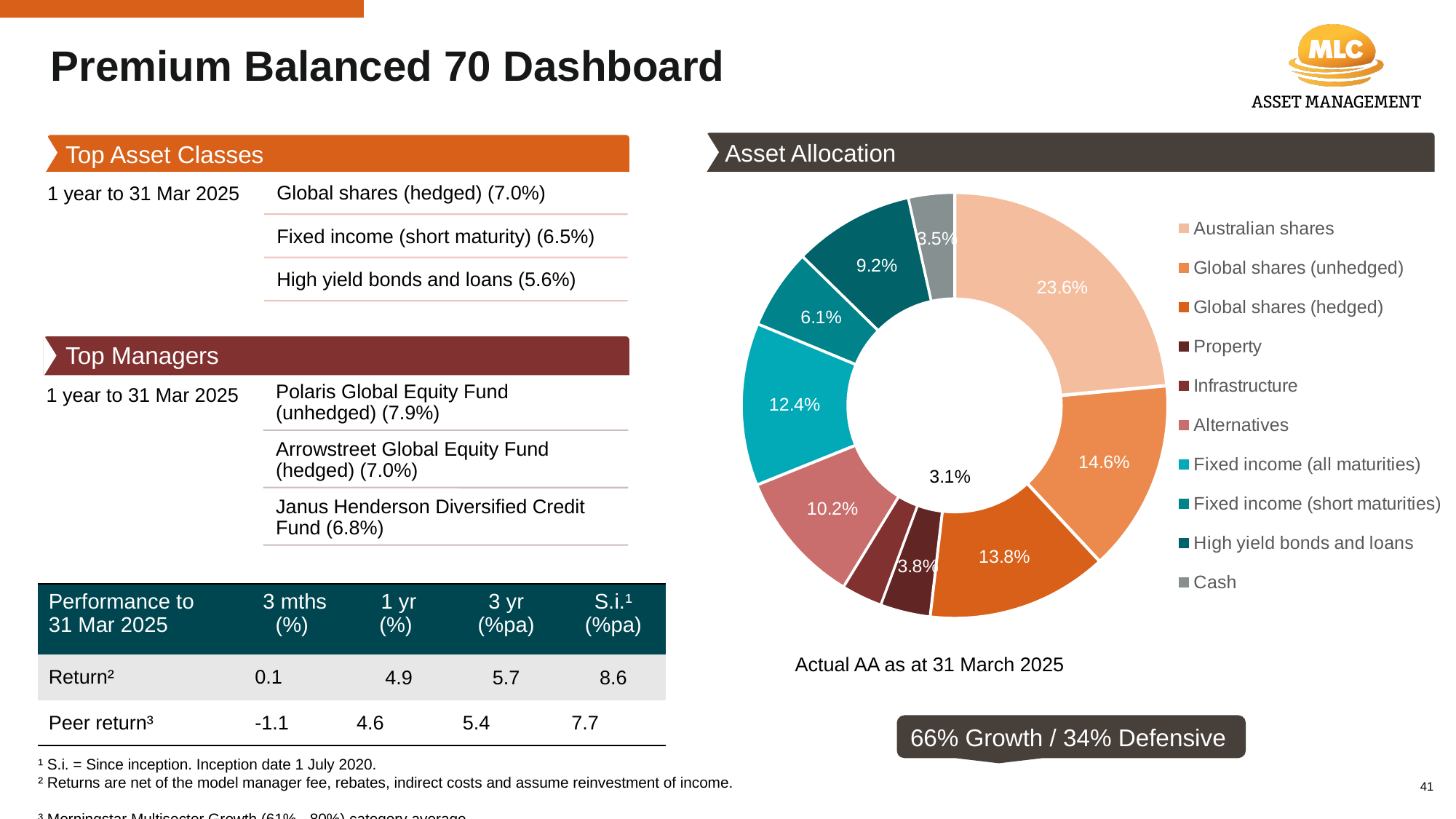
Which asset class has the largest share in the Asset Allocation chart? Australian shares In the Asset Allocation chart, what percentage is allocated to Fixed income (all maturities)? 12.4% What growth/defensive split is shown below the Asset Allocation chart? 66% Growth / 34% Defensive In the Asset Allocation chart, which is larger: Alternatives or High yield bonds and loans? Alternatives In the Asset Allocation chart, what percentage is allocated to High yield bonds and loans? 9.2% In the Asset Allocation chart, what percentage is allocated to Global shares (unhedged)? 14.6% In the Asset Allocation chart, what percentage is allocated to Australian shares? 23.6% What date is the Asset Allocation chart stated to be as at? 31 March 2025 In the Asset Allocation chart, how many percentage points larger is Australian shares than Global shares (unhedged)? 9.0 percentage points What kind of chart is shown under the Asset Allocation heading? Pie (donut) chart How many asset classes does the legend of the Asset Allocation chart list? 10 In the Asset Allocation chart, what percentage is allocated to Cash? 3.5%